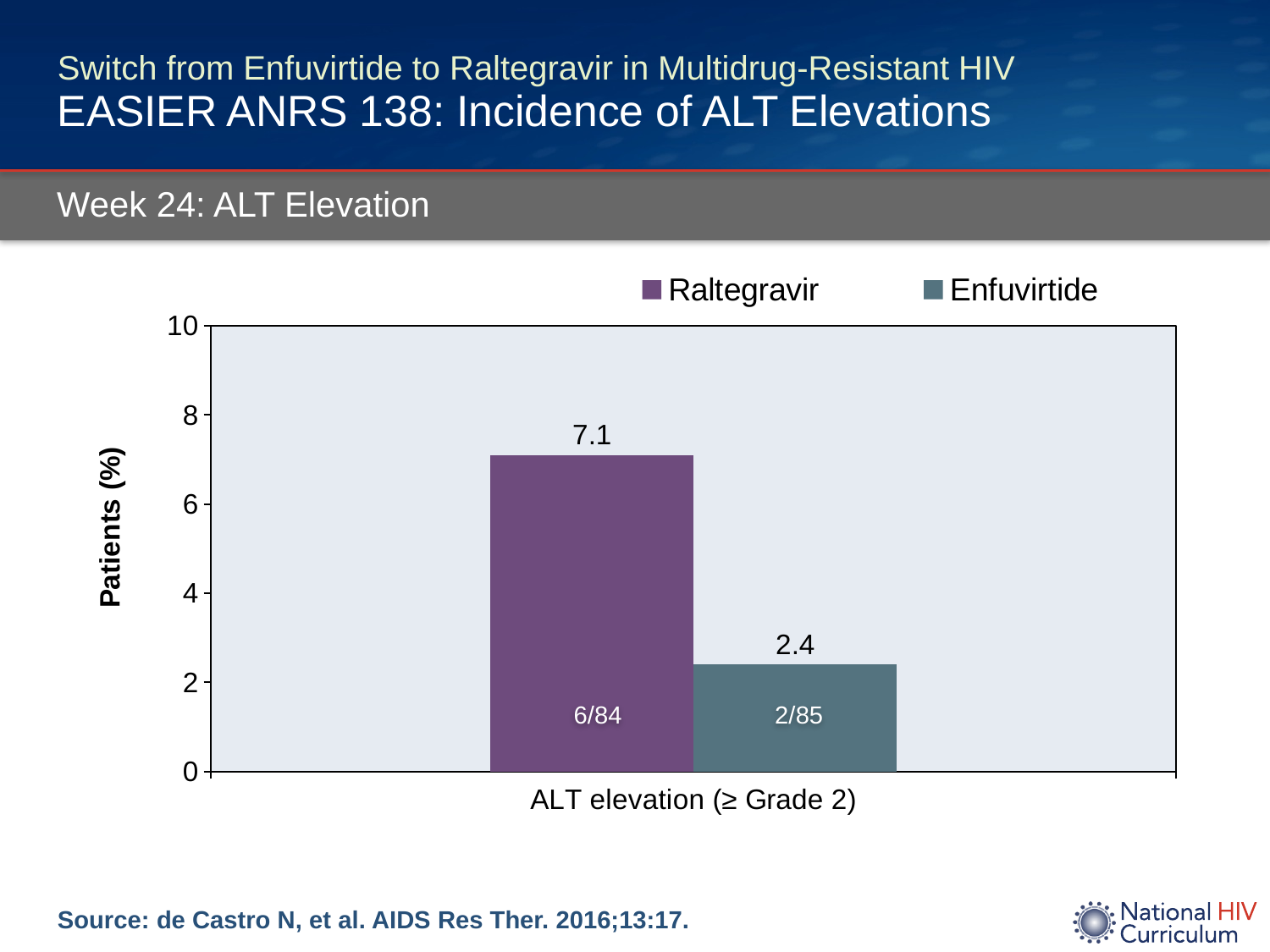
Which series has the higher value for ALT elevation (≥ Grade 2)? Raltegravir What kind of chart is shown on the slide? bar chart Is the value for Raltegravir larger or smaller than the value for Enfuvirtide? larger Which series has the lower value for ALT elevation (≥ Grade 2)? Enfuvirtide How many series does the legend list? 2 Is the value for Enfuvirtide greater or less than 4? less Is the value for Raltegravir greater or less than 6? greater What is the label of the y axis? Patients (%) What is the difference between the Raltegravir and Enfuvirtide values for ALT elevation (≥ Grade 2)? 4.7 What is the value for Raltegravir for ALT elevation (≥ Grade 2)? 7.1 What is the value for Enfuvirtide for ALT elevation (≥ Grade 2)? 2.4 What fraction of patients is printed on the Raltegravir bar? 6/84